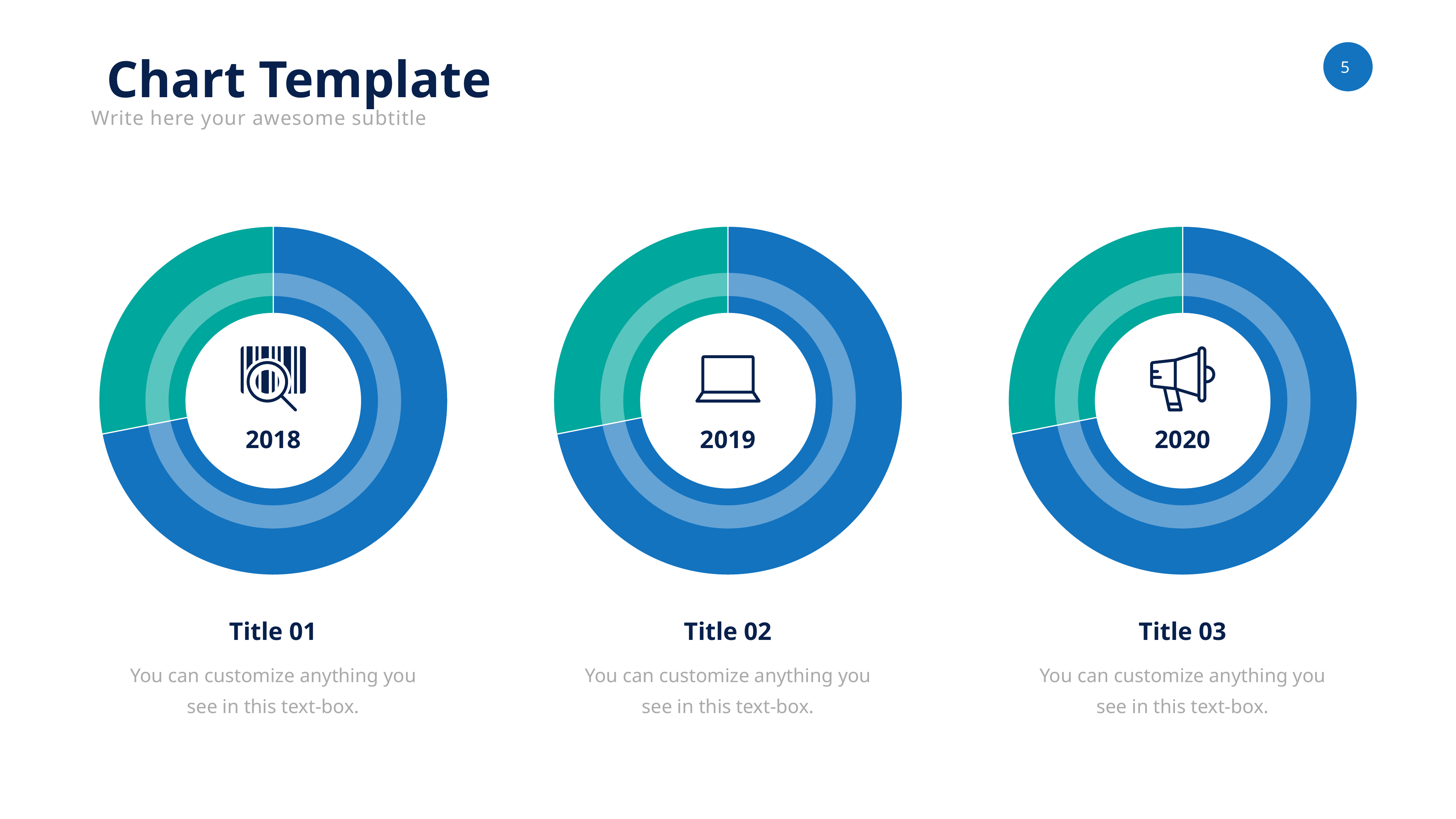
In the chart labelled 2018, which colour slice is the largest? Blue In the chart labelled 2020, which colour slice is the smallest? Teal What is the title printed below the rightmost doughnut chart? Title 03 What kind of chart is shown under Title 01? Doughnut chart In the chart labelled 2019, which slice is larger, the blue one or the teal one? Blue In the chart labelled 2018, how many slices does the outer ring have? 2 How many doughnut charts are on the slide? 3 What year is printed in the centre of the chart under Title 02? 2019